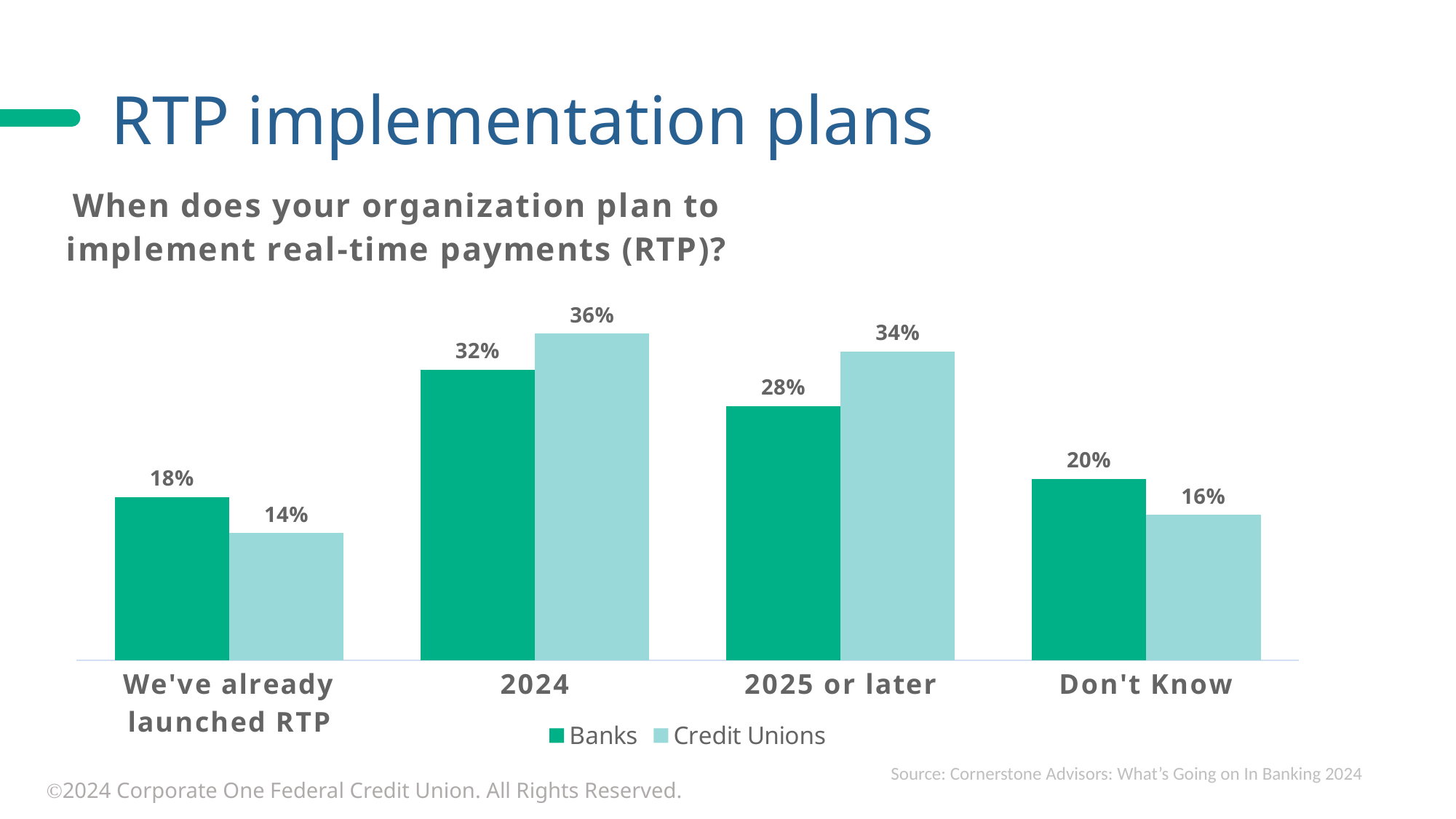
What kind of chart is shown on the slide? Bar chart Which category has the highest value for Banks? 2024 What is the difference between Banks and Credit Unions in the 'Don't Know' category? 4% How many categories are shown on the x axis? 4 What is the difference between Credit Unions and Banks for '2025 or later'? 6% For 'We've already launched RTP', which is larger: Banks or Credit Unions? Banks What is the value for Credit Unions in the 'Don't Know' category? 16% How many series does the legend list? 2 What percentage of Credit Unions plan to implement RTP in 2024? 36% What percentage of Banks say they have already launched RTP? 18% What are the two series listed in the legend? Banks and Credit Unions Which category has the lowest value for Credit Unions? We've already launched RTP